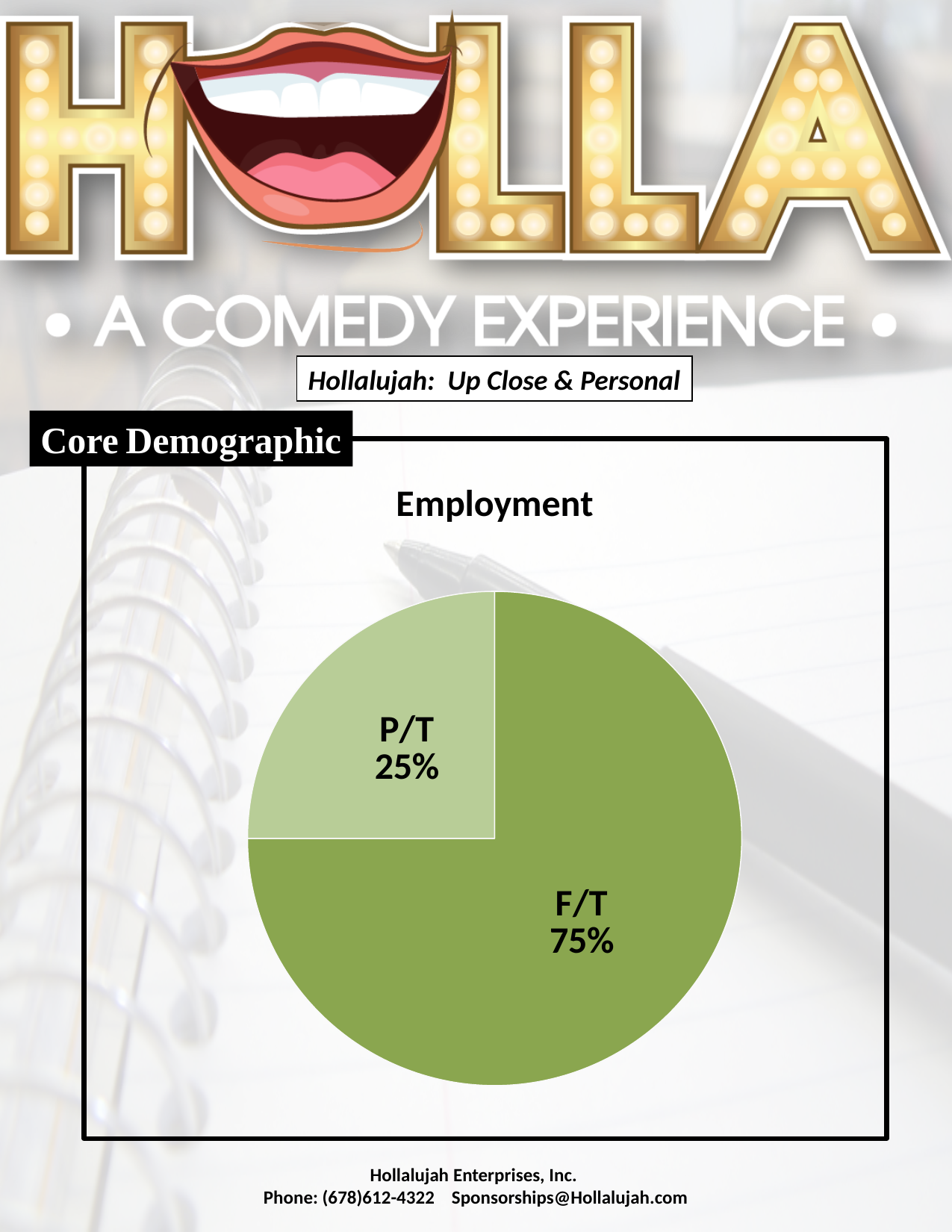
What is the title of the chart? Employment Which slice of the Employment pie is the largest? F/T What is the combined percentage of the F/T and P/T slices? 100% What is the difference in percentage points between the F/T and P/T slices? 50 Which slice of the Employment pie is the smallest? P/T What share of the Employment pie is P/T? 25% What share of the Employment pie is F/T? 75% Which slice of the Employment pie is shown in the lighter green colour? P/T Which is larger in the Employment pie, P/T or F/T? F/T How many slices does the Employment pie chart have? 2 What type of chart is shown under the title "Employment"? pie chart